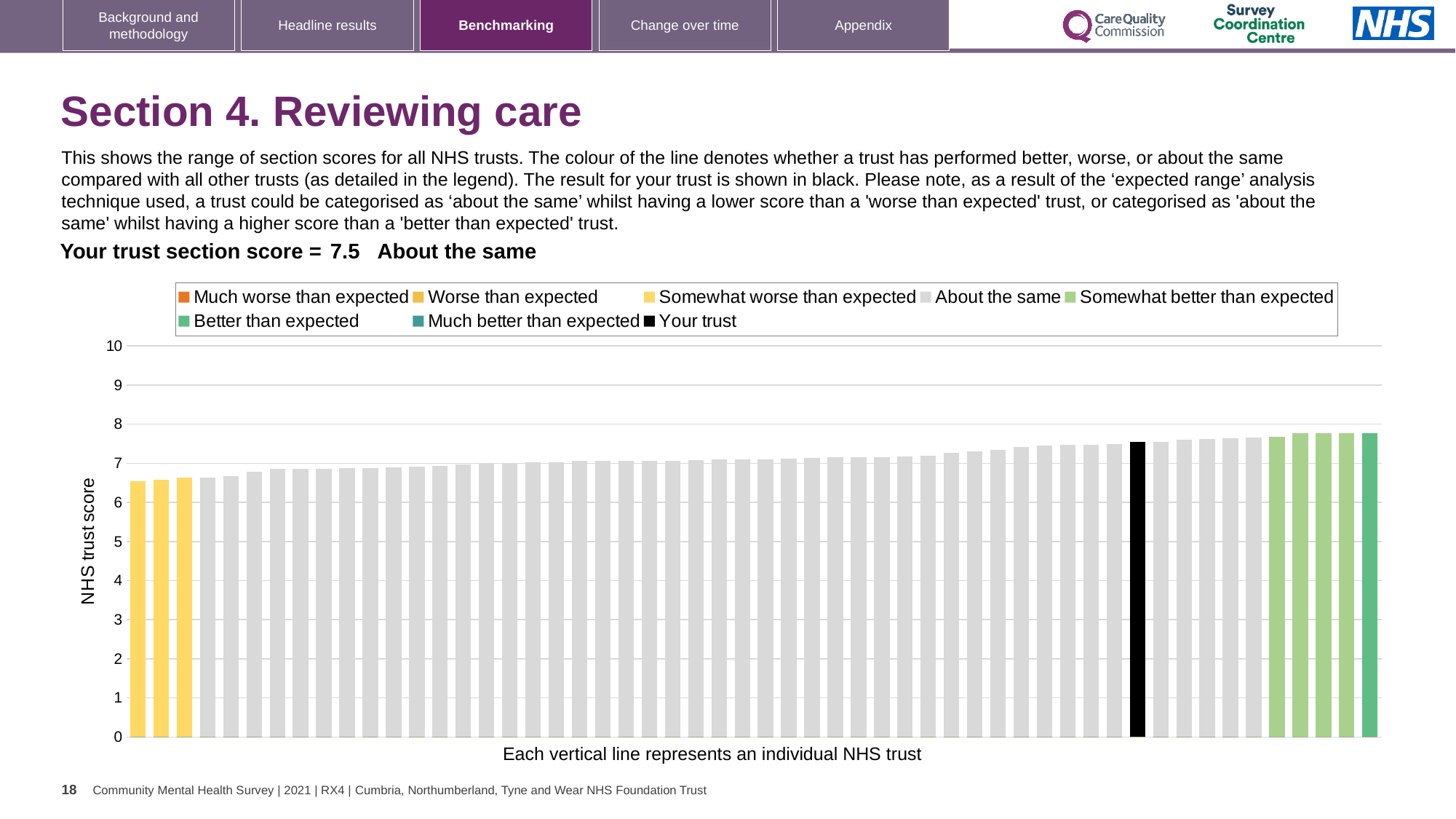
Which is larger, the value of the black 'Your trust' bar or the value of the leftmost bar? Your trust bar What is the label on the vertical axis of the chart? NHS trust score What category is your trust's section score placed in? About the same How many yellow 'Somewhat worse than expected' bars are shown in the chart? 3 Is the value of the black 'Your trust' bar greater or less than 7? greater Is the value of the rightmost bar greater or less than 8? less How many entries does the chart legend list? 8 Do the bar values rise or fall from left to right along the x axis? rise What kind of chart is shown on the slide? bar chart Is the value of the leftmost bar greater or less than 7? less What is the section score for your trust? 7.5 What is the highest value shown on the vertical axis? 10